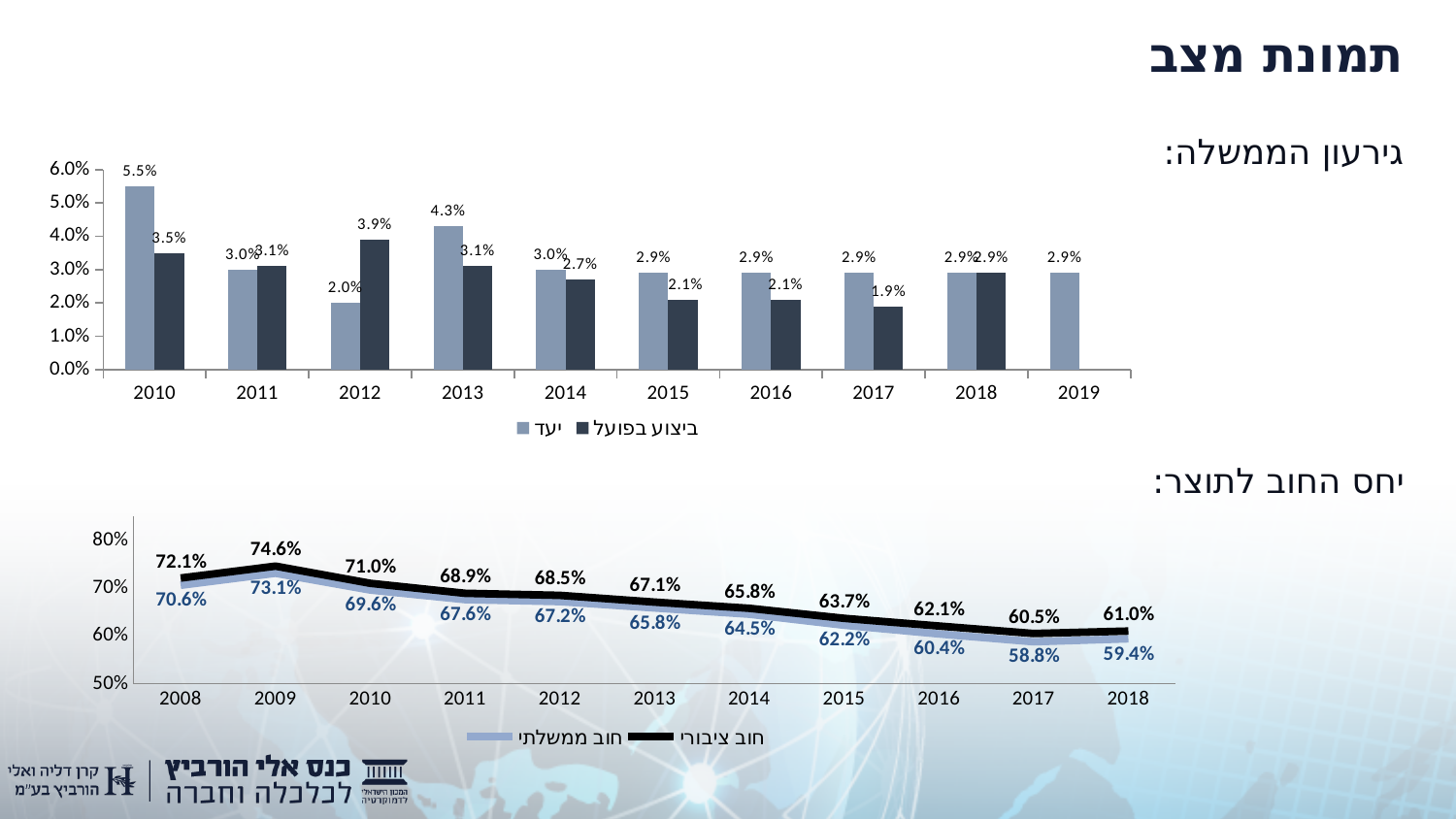
In the bottom chart (יחס החוב לתוצר), do the values of the black line generally rise or fall from 2009 to 2017? Fall In the top chart (גירעון הממשלה), what is the value of the dark bar for 2012? 3.9% In the top chart (גירעון הממשלה), which year has the highest light blue bar? 2010 How many series does the legend of the top chart (גירעון הממשלה) list? 2 How many years are shown on the x axis of the top chart (גירעון הממשלה)? 10 In the bottom chart (יחס החוב לתוצר), which is larger in 2014: the black line or the light blue line? The black line (65.8%) In the top chart (גירעון הממשלה), what is the value of the light blue bar for 2010? 5.5% In the top chart (גירעון הממשלה), what is the difference between the light blue bar and the dark bar for 2013? 1.2 percentage points In the bottom chart (יחס החוב לתוצר), what is the value of the black line in 2009? 74.6% In the bottom chart (יחס החוב לתוצר), what is the value of the light blue line in 2017? 58.8% What kind of chart is the bottom chart (יחס החוב לתוצר)? Line chart What kind of chart is the top chart (גירעון הממשלה)? Bar chart